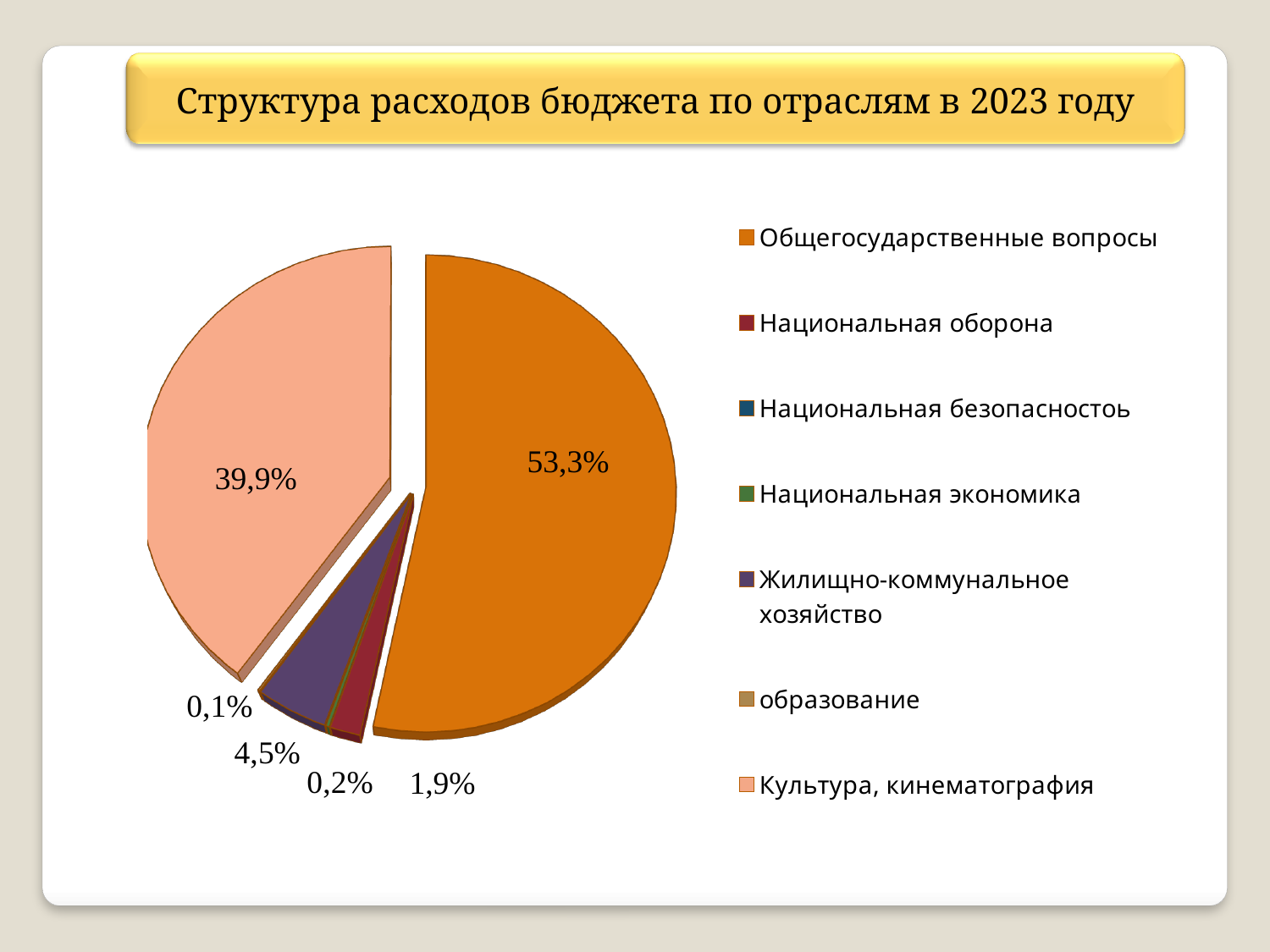
What share is labelled for Жилищно-коммунальное хозяйство? 4,5% What colour is the slice for Общегосударственные вопросы? orange Which category has the largest slice of the pie? Общегосударственные вопросы What is the difference in percentage points between the Культура, кинематография slice and the Жилищно-коммунальное хозяйство slice? 35,4% What is the title of the slide? Структура расходов бюджета по отраслям в 2023 году Which is larger: the slice for Общегосударственные вопросы or the slice for Культура, кинематография? Общегосударственные вопросы What is the difference in percentage points between the Общегосударственные вопросы slice and the Культура, кинематография slice? 13,4% What share is labelled for Национальная оборона? 1,9% What share is labelled for Культура, кинематография? 39,9% How many categories does the legend list? 7 What kind of chart is shown on the slide? pie chart What share of budget expenditure is labelled for Общегосударственные вопросы? 53,3%